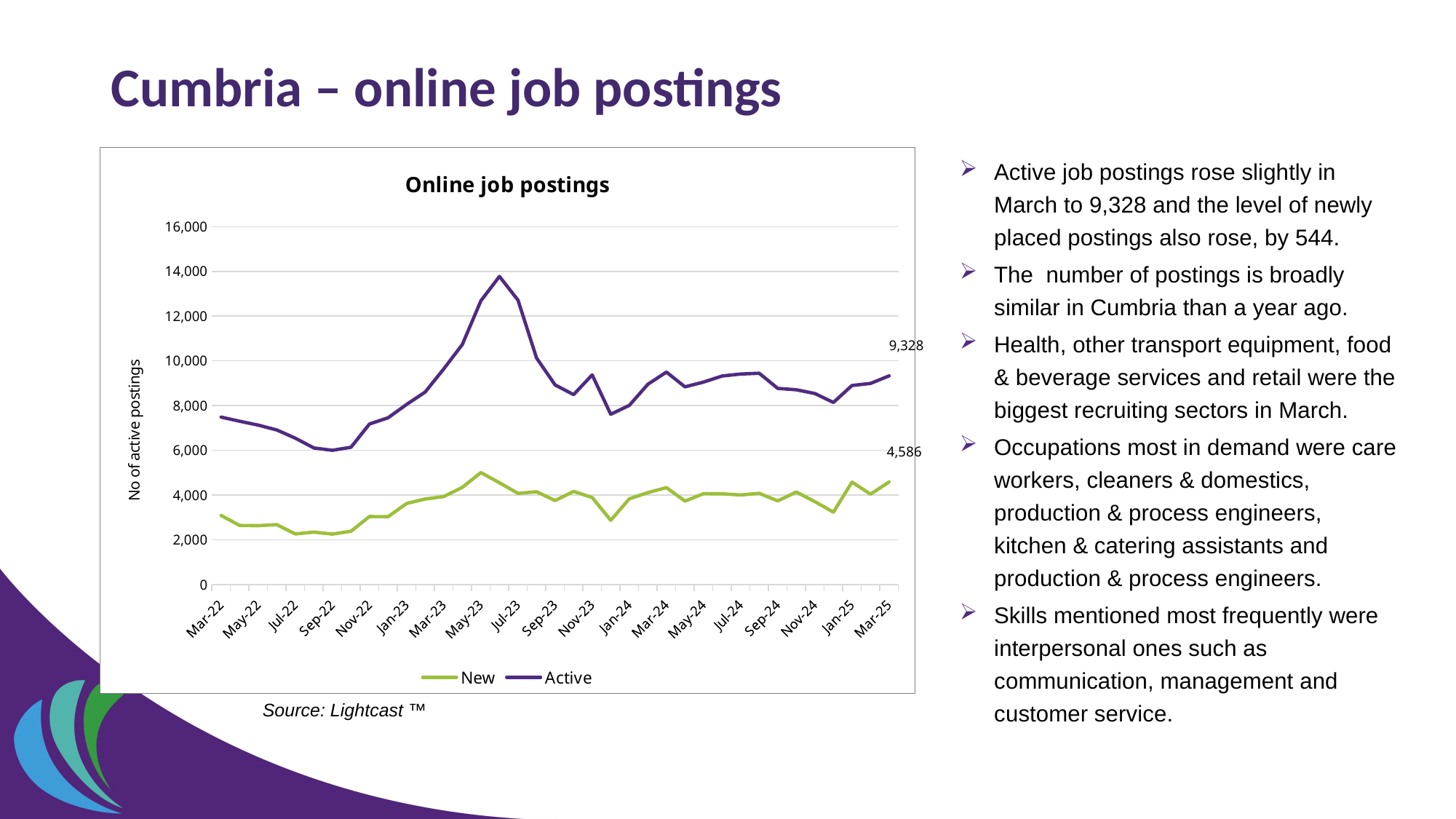
What is the value of the New series at Mar-25? 4,586 How many series does the legend list? 2 What is the difference between the Active and New values at Mar-25? 4,742 Is the value of the New series at Mar-22 greater or less than 2,000? greater Is the value of the Active series at Sep-22 greater or less than 8,000? less What is the title of the chart? Online job postings What kind of chart is shown? Line chart At Mar-25, which series has the larger value, New or Active? Active Is the highest value of the Active series greater or less than 12,000? greater What colour is the Active line? Purple What is the value of the Active series at Mar-25? 9,328 Does the Active series rise or fall between Mar-22 and Sep-22? Fall